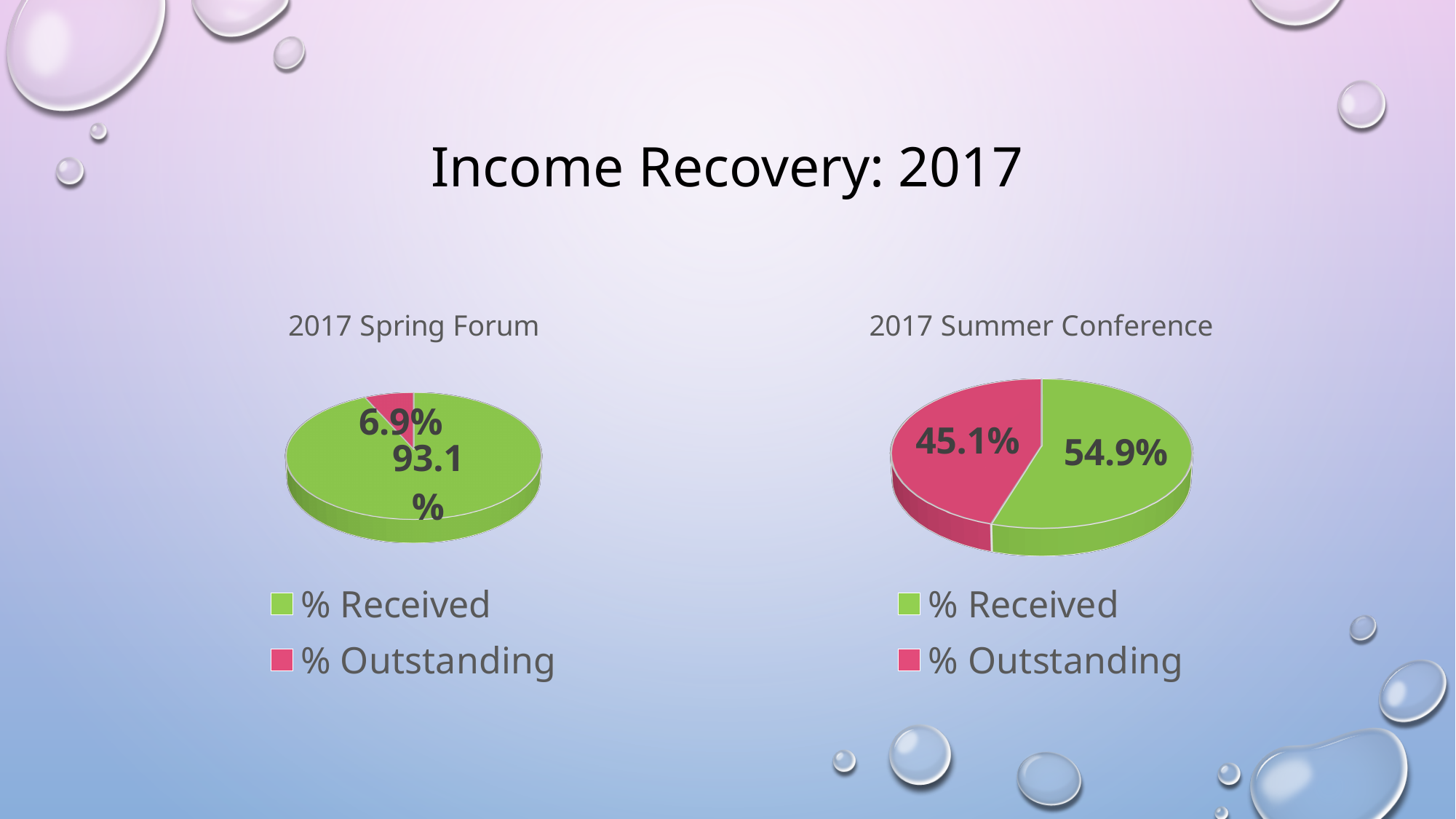
In the 2017 Summer Conference chart, what percentage is shown for % Received? 54.9% In the 2017 Spring Forum chart, what percentage is shown for % Outstanding? 6.9% In the 2017 Spring Forum chart, what is the difference between % Received and % Outstanding? 86.2% In the 2017 Spring Forum chart, what percentage is shown for % Received? 93.1% What kind of chart is the 2017 Spring Forum chart? Pie chart In the 2017 Summer Conference chart, what is the difference between % Received and % Outstanding? 9.8% How many entries does the legend of the 2017 Spring Forum chart list? 2 In the 2017 Summer Conference chart, what percentage is shown for % Outstanding? 45.1% In the 2017 Summer Conference chart, which slice is larger, % Received or % Outstanding? % Received How many slices does the 2017 Summer Conference chart have? 2 In the 2017 Spring Forum chart, which slice is the smallest? % Outstanding In the 2017 Summer Conference chart, what colour is the % Outstanding slice? Pink